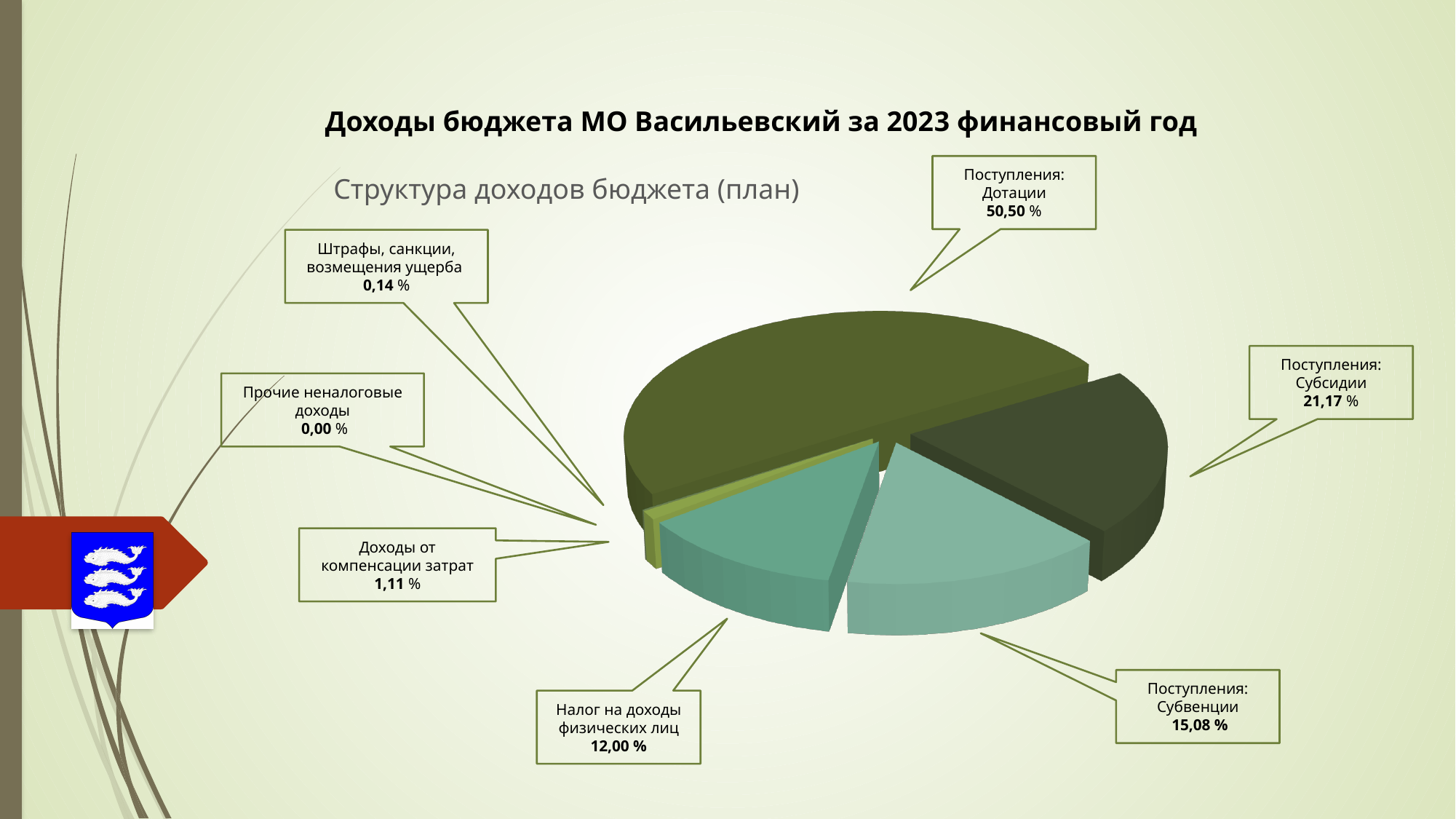
What share is shown for "Доходы от компенсации затрат"? 1,11 % Which is larger: the share for "Поступления: Субсидии" or for "Поступления: Субвенции"? Поступления: Субсидии Which category has the largest share of the pie? Поступления: Дотации What share is shown for "Налог на доходы физических лиц"? 12,00 % What kind of chart is shown on the slide? Pie chart What share is shown for "Штрафы, санкции, возмещения ущерба"? 0,14 % Which category has the smallest share of the pie? Прочие неналоговые доходы What share is shown for "Поступления: Субвенции"? 15,08 % How many categories are labelled on the pie chart? 7 What is the chart's title? Структура доходов бюджета (план) What share of the pie is labelled for "Поступления: Дотации"? 50,50 % What share is shown for "Поступления: Субсидии"? 21,17 %